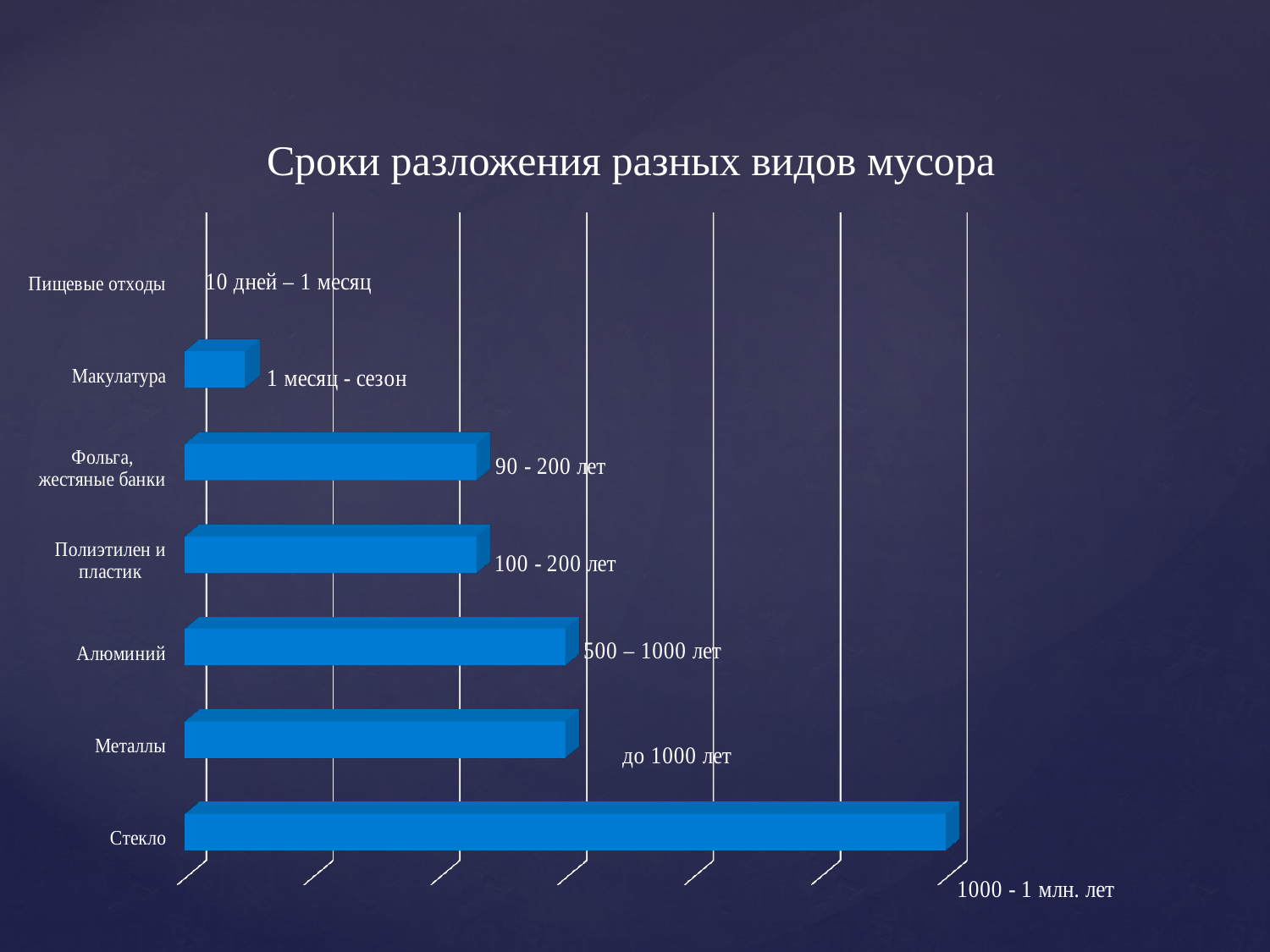
What kind of chart is shown on the slide? bar chart Which bar is longer, Алюминий or Фольга, жестяные банки? Алюминий What decomposition time is labelled for Полиэтилен и пластик? 100 - 200 лет Going from the top category to the bottom category, do the bars get longer or shorter? longer What is the title of the chart? Сроки разложения разных видов мусора What decomposition time is labelled for Стекло? 1000 - 1 млн. лет What decomposition time is labelled for Макулатура? 1 месяц - сезон What decomposition time is labelled for Пищевые отходы? 10 дней – 1 месяц Which category has the longest bar in the chart? Стекло What decomposition time is labelled for Алюминий? 500 – 1000 лет What decomposition time is labelled for Металлы? до 1000 лет How many categories of waste are shown in the chart? 7